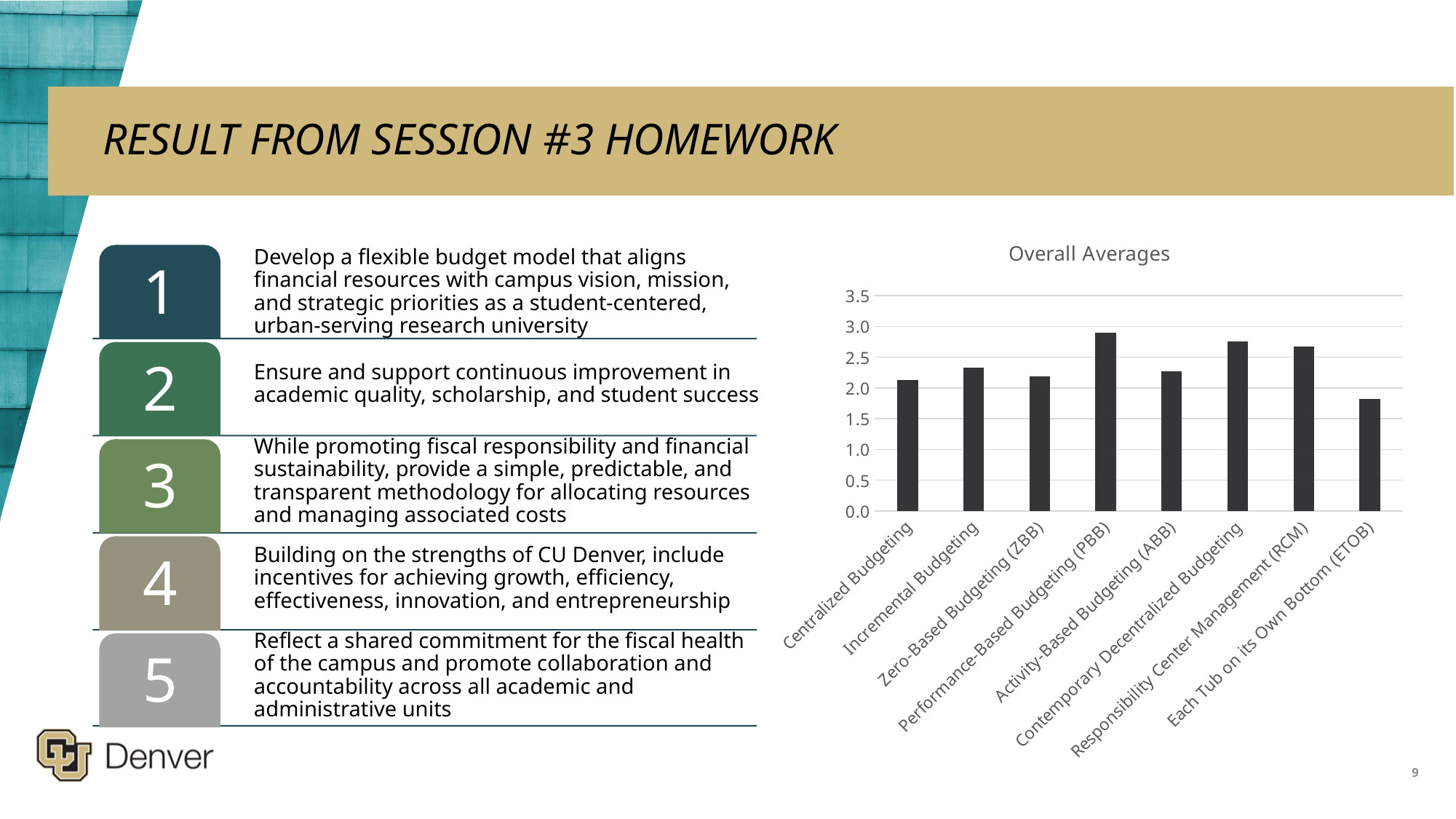
Which budgeting model has the lowest overall average? Each Tub on its Own Bottom (ETOB) Which has a higher overall average, Responsibility Center Management (RCM) or Zero-Based Budgeting (ZBB)? Responsibility Center Management (RCM) Is the value for Contemporary Decentralized Budgeting greater or less than 2.5? greater Which has a higher overall average, Activity-Based Budgeting (ABB) or Each Tub on its Own Bottom (ETOB)? Activity-Based Budgeting (ABB) How many budgeting models are shown on the x axis of the chart? 8 What is the title of the chart on the slide? Overall Averages Is the value for Incremental Budgeting greater or less than 2.5? less Is the value for Centralized Budgeting greater or less than 2.0? greater Which budgeting model has the highest overall average? Performance-Based Budgeting (PBB) What kind of chart is shown on the slide? bar chart